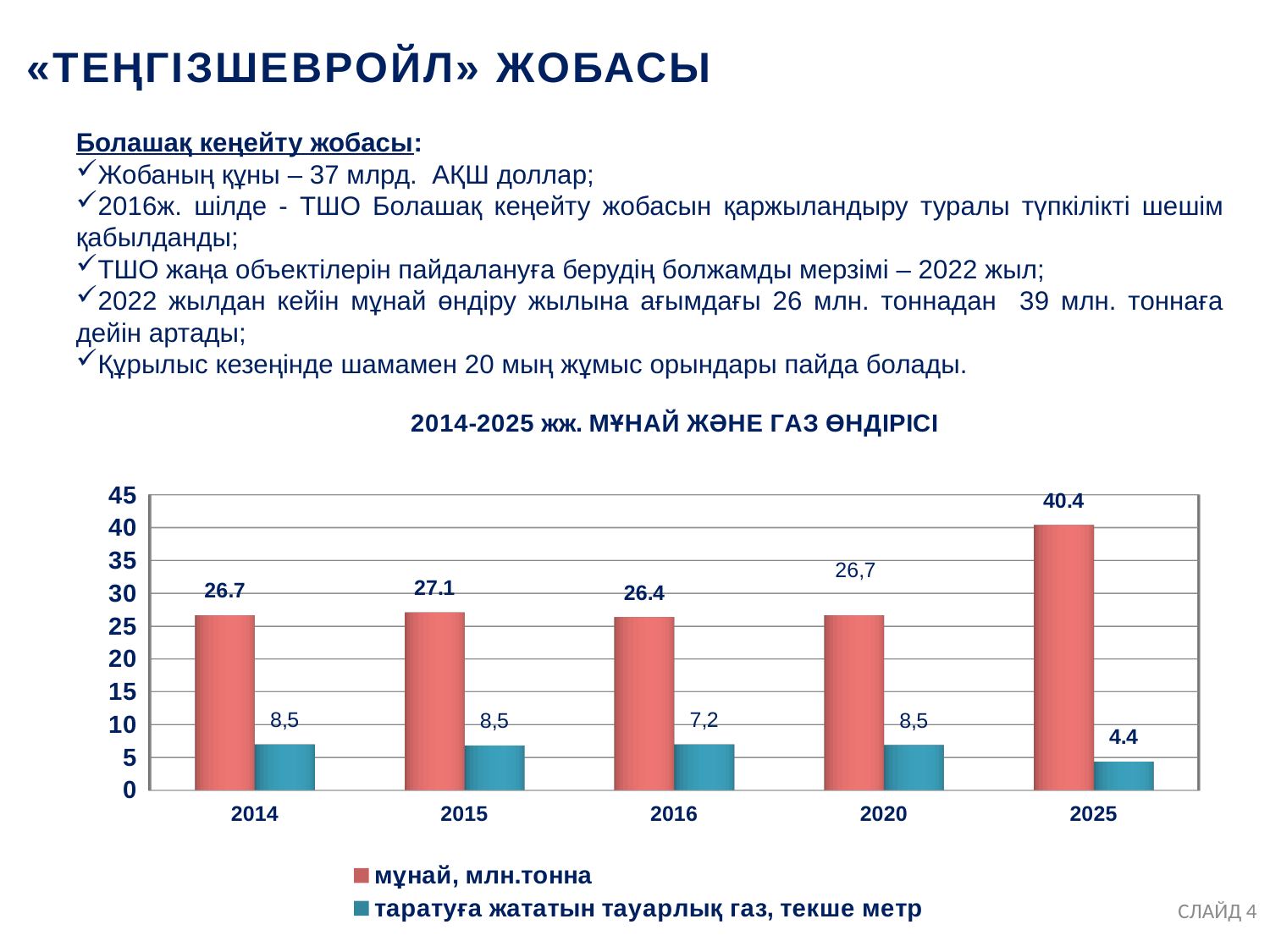
Which year has the lowest value for таратуға жататын тауарлық газ, текше метр? 2025 How many series does the legend list? 2 How many years are shown on the x axis? 5 Which is larger, the мұнай, млн.тонна value for 2015 or for 2016? 2015 What is the value of таратуға жататын тауарлық газ, текше метр for 2025? 4.4 What is the value of таратуға жататын тауарлық газ, текше метр for 2016? 7,2 Which year has the highest value for мұнай, млн.тонна? 2025 What is the value of мұнай, млн.тонна for 2025? 40.4 What kind of chart is shown on the slide? Bar chart What is the value of мұнай, млн.тонна for 2014? 26.7 What is the title of the chart? 2014-2025 жж. МҰНАЙ ЖӘНЕ ГАЗ ӨНДІРІСІ What is the difference between the мұнай, млн.тонна values for 2025 and 2014? 13.7